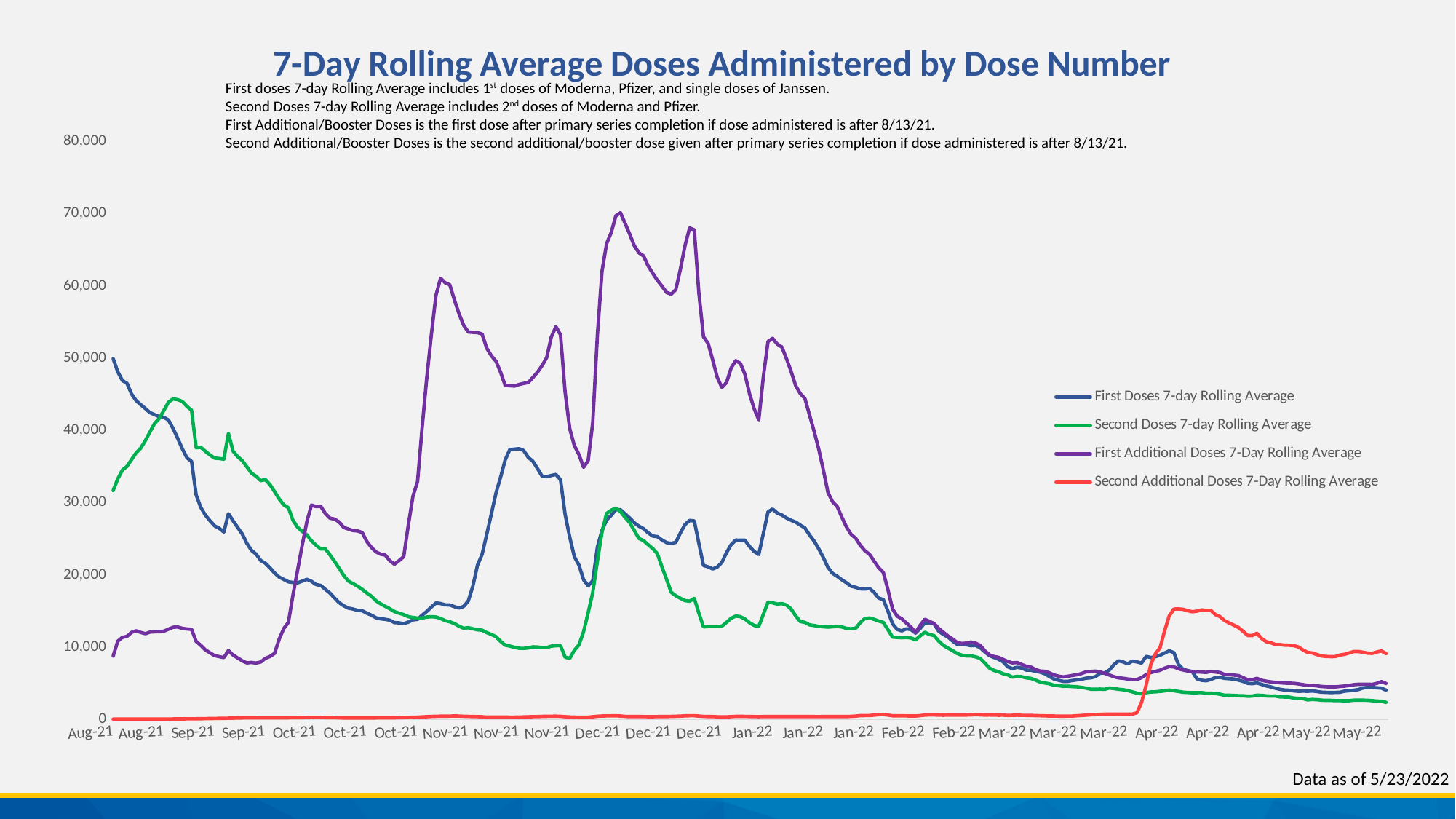
How many series does the legend list? 4 Which series is drawn in red? Second Additional Doses 7-Day Rolling Average Which series has the lowest value at the right end of the chart (May-22)? Second Doses 7-day Rolling Average What is the title of the chart? 7-Day Rolling Average Doses Administered by Dose Number What kind of chart is shown on the slide? line chart Which series has the highest value at the right end of the chart (May-22)? Second Additional Doses 7-Day Rolling Average Is the peak value of the Second Additional Doses 7-Day Rolling Average in Apr-22 greater or less than 10,000? greater Does the First Doses 7-day Rolling Average overall rise or fall from Aug-21 to May-22? fall Is the peak value of the First Additional Doses 7-Day Rolling Average in Dec-21 greater or less than 60,000? greater Which series reaches the highest value anywhere on the chart? First Additional Doses 7-Day Rolling Average Is the value of the First Doses 7-day Rolling Average at the start of the chart (Aug-21) greater or less than 40,000? greater